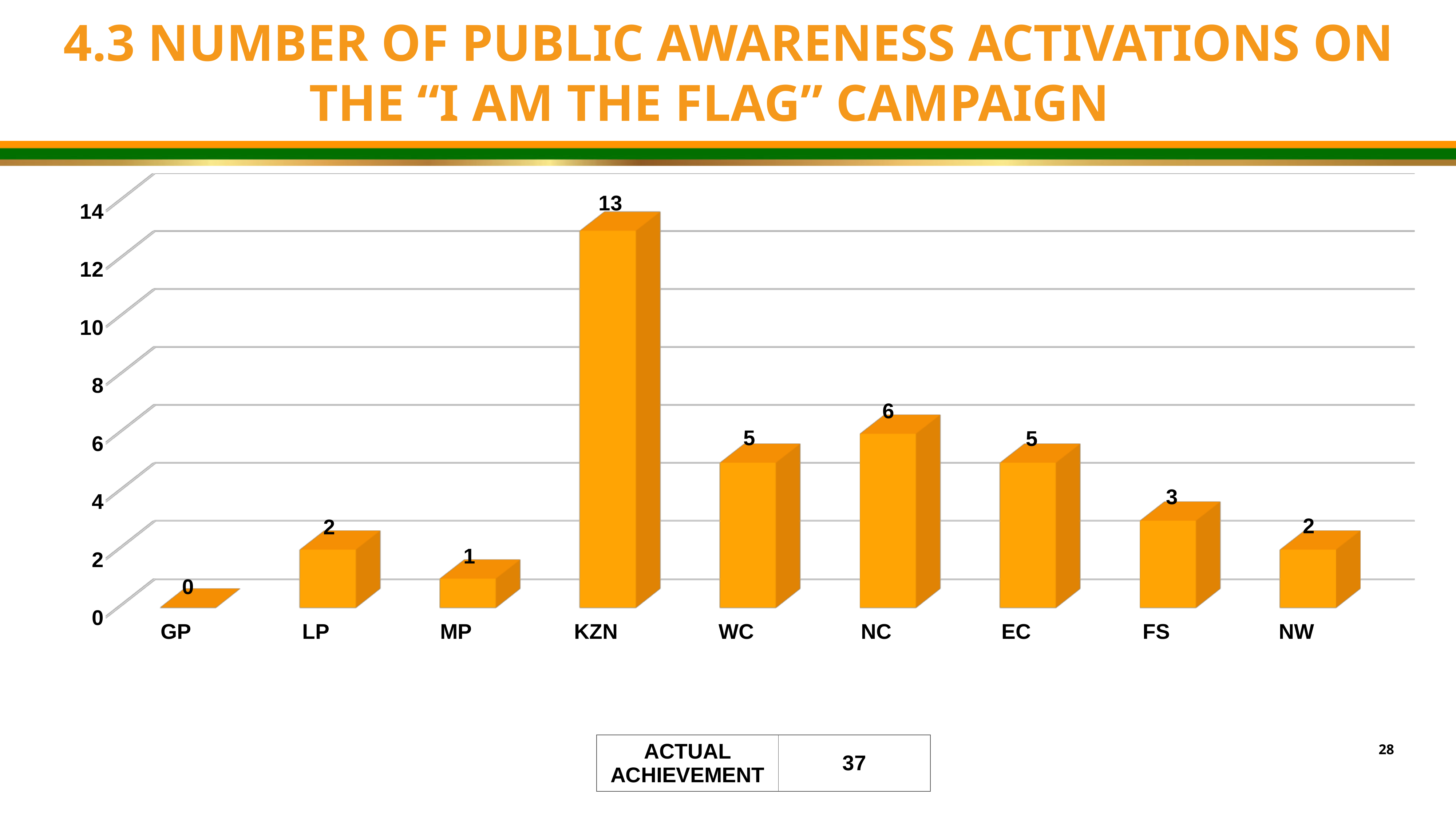
How many categories are shown on the x axis? 9 Which category has the lowest value? GP What is the value for KZN? 13 What is the difference between the values for KZN and NC? 7 What is the value for GP? 0 Which is larger, the value for LP or the value for MP? LP What kind of chart is shown on the slide? bar chart What is the value for NC? 6 What is the difference between the values for WC and NW? 3 What is the value for FS? 3 Which category has the highest value? KZN What colour are the bars in the chart? orange